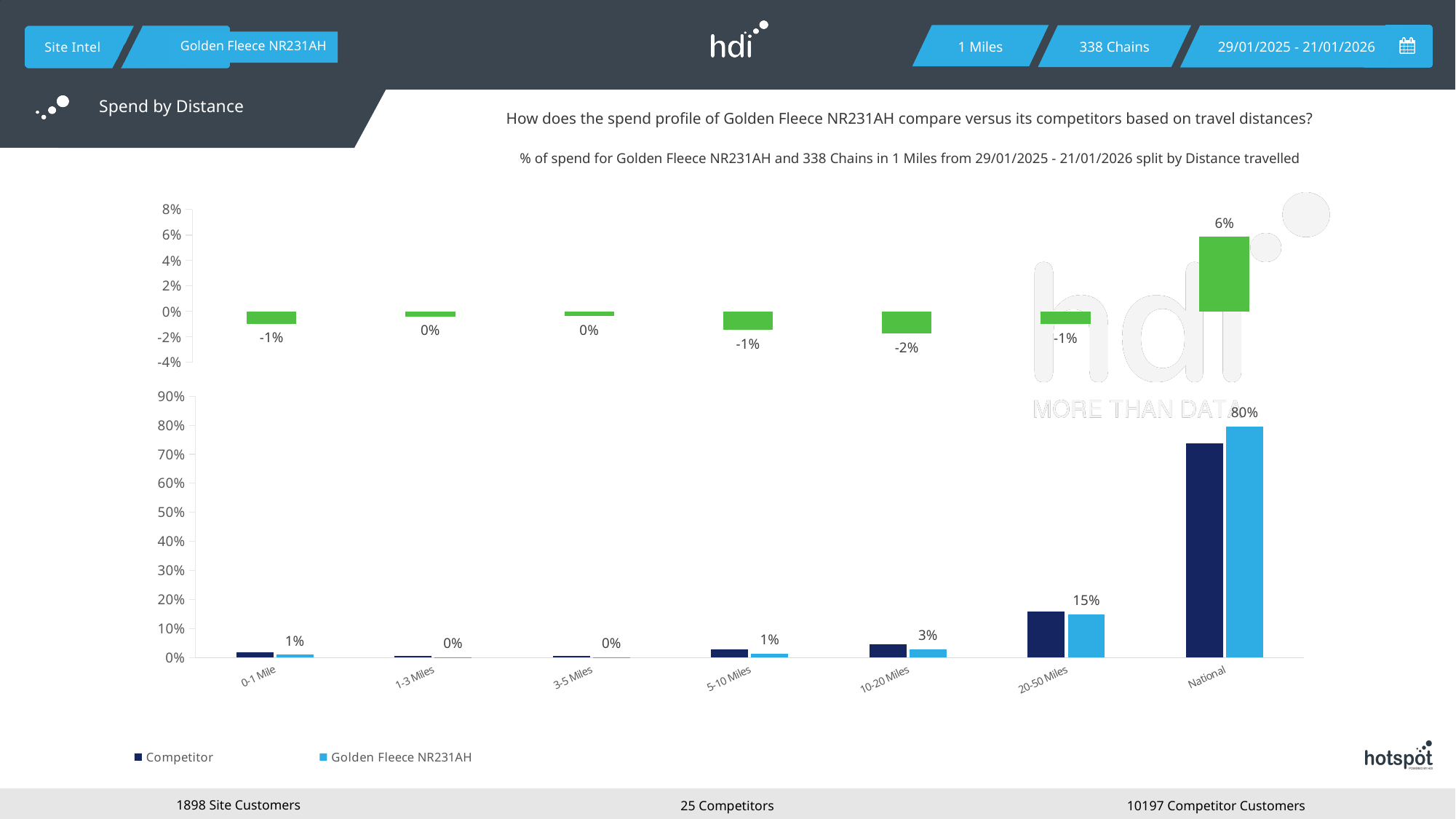
How many distance categories are shown on the x axis of the bottom chart? 7 In the bottom chart, which category has the highest value for Golden Fleece NR231AH? National In the top chart, which category has the lowest value? 10-20 Miles In the bottom chart, what is the value for Golden Fleece NR231AH in the National category? 80% In the top chart, what is the value shown for the National category? 6% In the bottom chart, what is the value for Golden Fleece NR231AH in the 20-50 Miles category? 15% In the bottom chart, is the Competitor value for National greater or less than 70%? greater In the bottom chart, which is larger in the National category: the Competitor bar or the Golden Fleece NR231AH bar? Golden Fleece NR231AH In the bottom chart, what is the value for Golden Fleece NR231AH in the 10-20 Miles category? 3% In the top chart, what is the value shown for the 10-20 Miles category? -2% How many series does the legend of the bottom chart list? 2 In the bottom chart, what is the difference between the Golden Fleece NR231AH values for National and 20-50 Miles? 65%